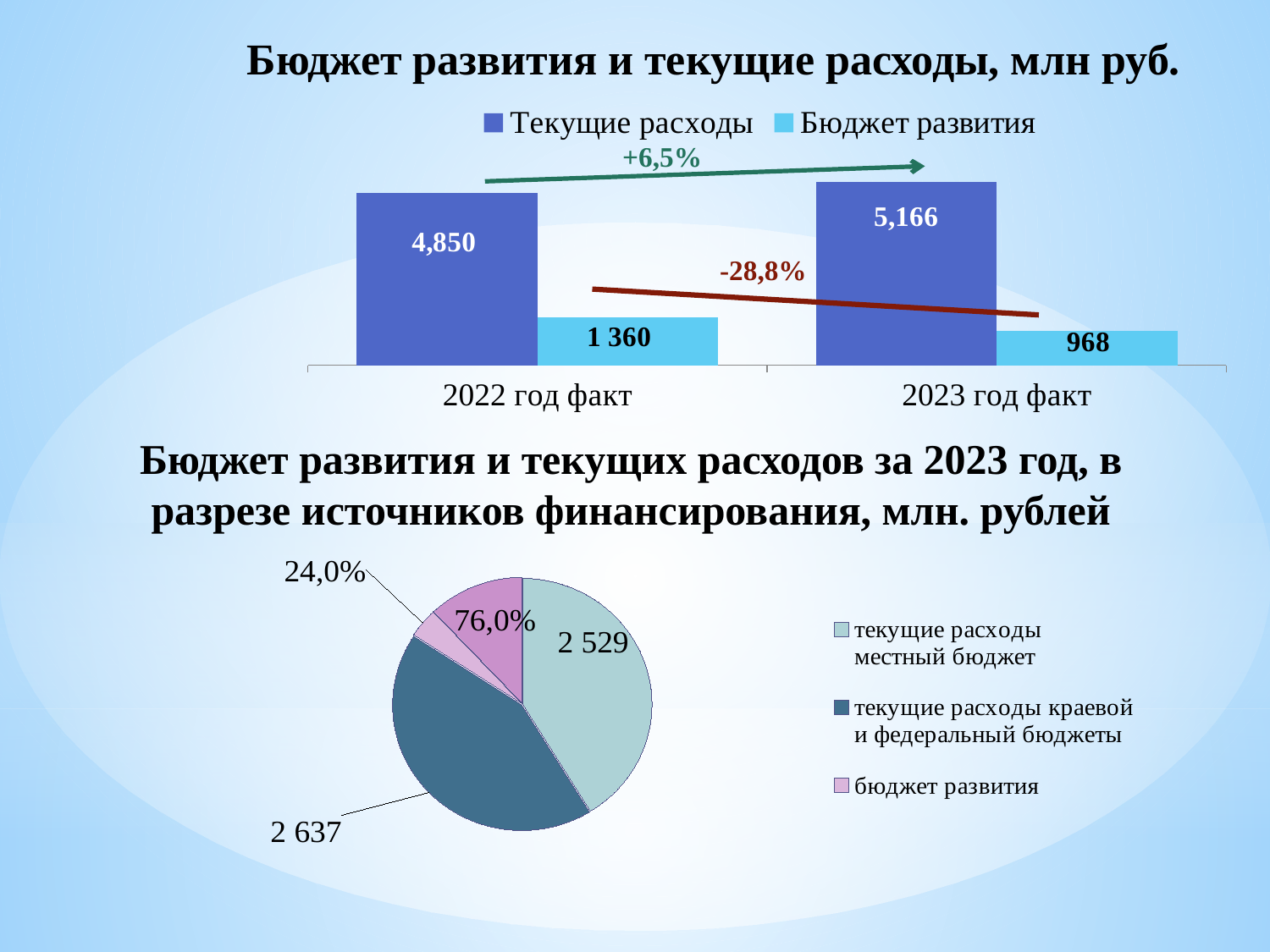
What type of chart is the top chart on the slide? bar chart In the top bar chart, what is the value of Текущие расходы for 2022 год факт? 4,850 In the top bar chart, which year has the higher value for Текущие расходы? 2023 год факт In the top bar chart, what is the value of Бюджет развития for 2023 год факт? 968 In the top bar chart, what percentage change is shown by the green arrow for Текущие расходы? +6,5% In the top bar chart, what is the value of Текущие расходы for 2023 год факт? 5,166 In the top bar chart, which year has the lower value for Бюджет развития? 2023 год факт In the top bar chart, what percentage change is shown by the red arrow for Бюджет развития? -28,8% In the bottom pie chart, what value is labelled on the slice for текущие расходы краевой и федеральный бюджеты? 2 637 In the bottom pie chart, what value is labelled on the slice for текущие расходы местный бюджет? 2 529 In the top bar chart, what is the value of Бюджет развития for 2022 год факт? 1 360 In the top bar chart, how many series does the legend list? 2